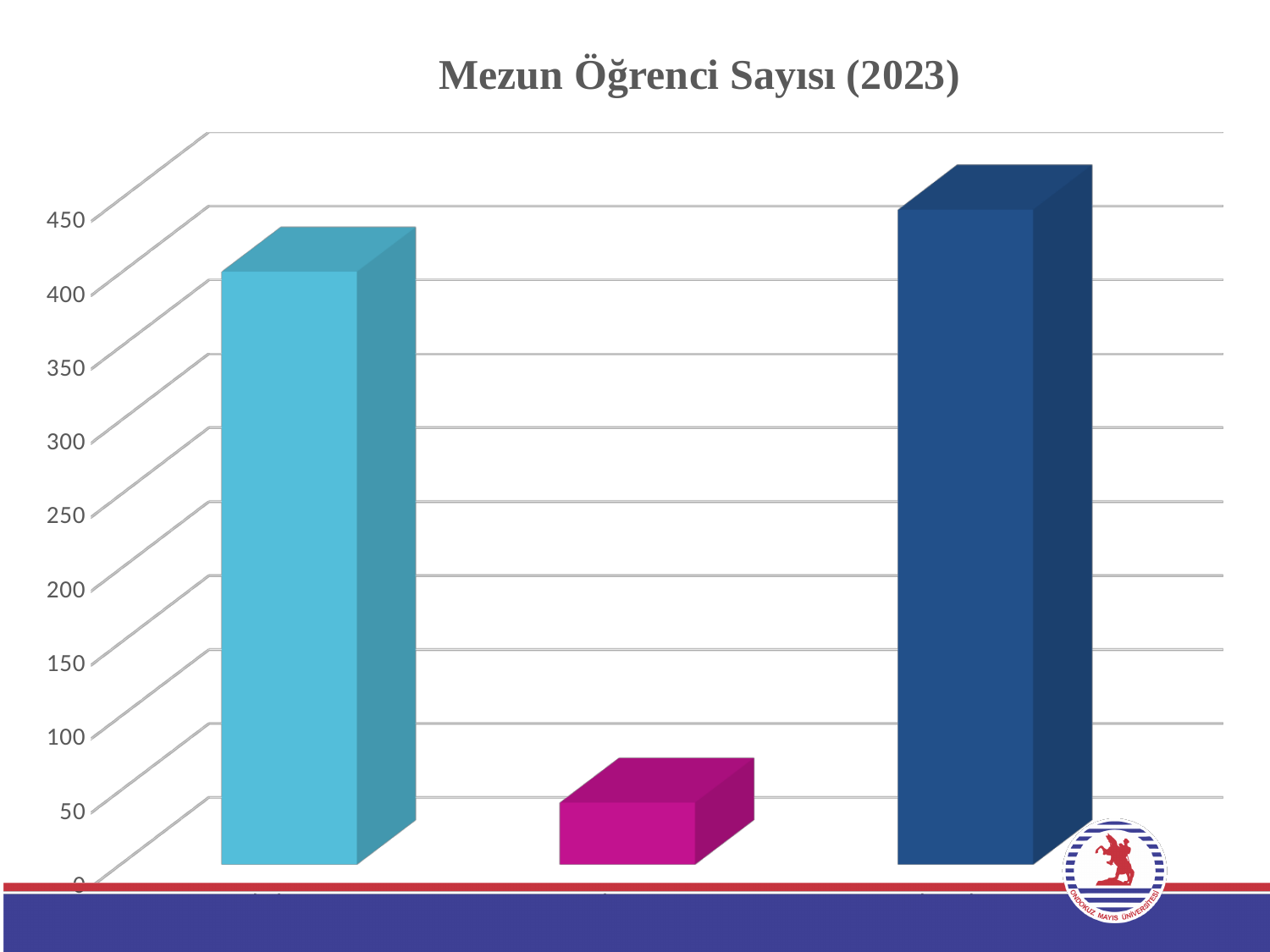
What kind of chart is shown on the slide? bar chart Which bar is the lowest in the chart? the magenta bar in the middle Which is larger, the light blue bar on the left or the magenta bar in the middle? the light blue bar on the left What is the title of the chart? Mezun Öğrenci Sayısı (2023) Which bar is the highest in the chart? the dark blue bar on the right Is the value of the dark blue bar on the right greater or less than 350? greater What is the highest value shown on the vertical axis? 450 Is the value of the light blue bar on the left greater or less than 300? greater Which is larger, the light blue bar on the left or the dark blue bar on the right? the dark blue bar on the right How many bars are plotted in the chart? 3 Is the value of the magenta bar in the middle greater or less than 100? less